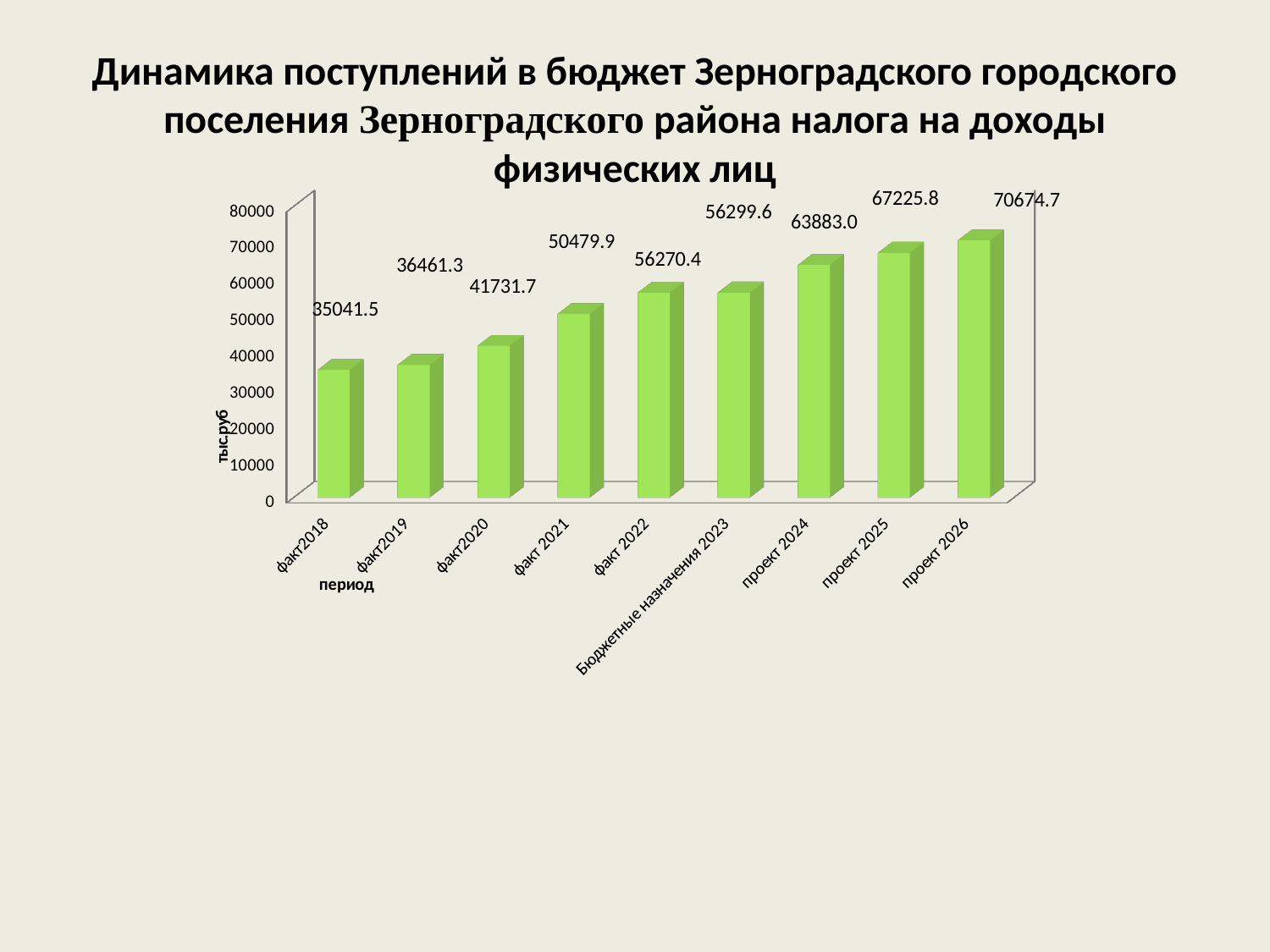
What is the value for факт2018? 35041.5 Which period has the highest value? проект 2026 How many periods are shown on the x axis? 9 Which period has the lowest value? факт2018 What is the value for Бюджетные назначения 2023? 56299.6 Which is larger, the value for факт 2021 or the value for факт2020? факт 2021 Is the value for проект 2024 greater or less than 60000? greater What is the value for проект 2025? 67225.8 Do the values rise or fall from факт2018 to проект 2026? rise What kind of chart is shown on the slide? bar chart What is the difference between the values for проект 2026 and факт2018? 35633.2 What is the difference between the values for проект 2025 and проект 2024? 3342.8